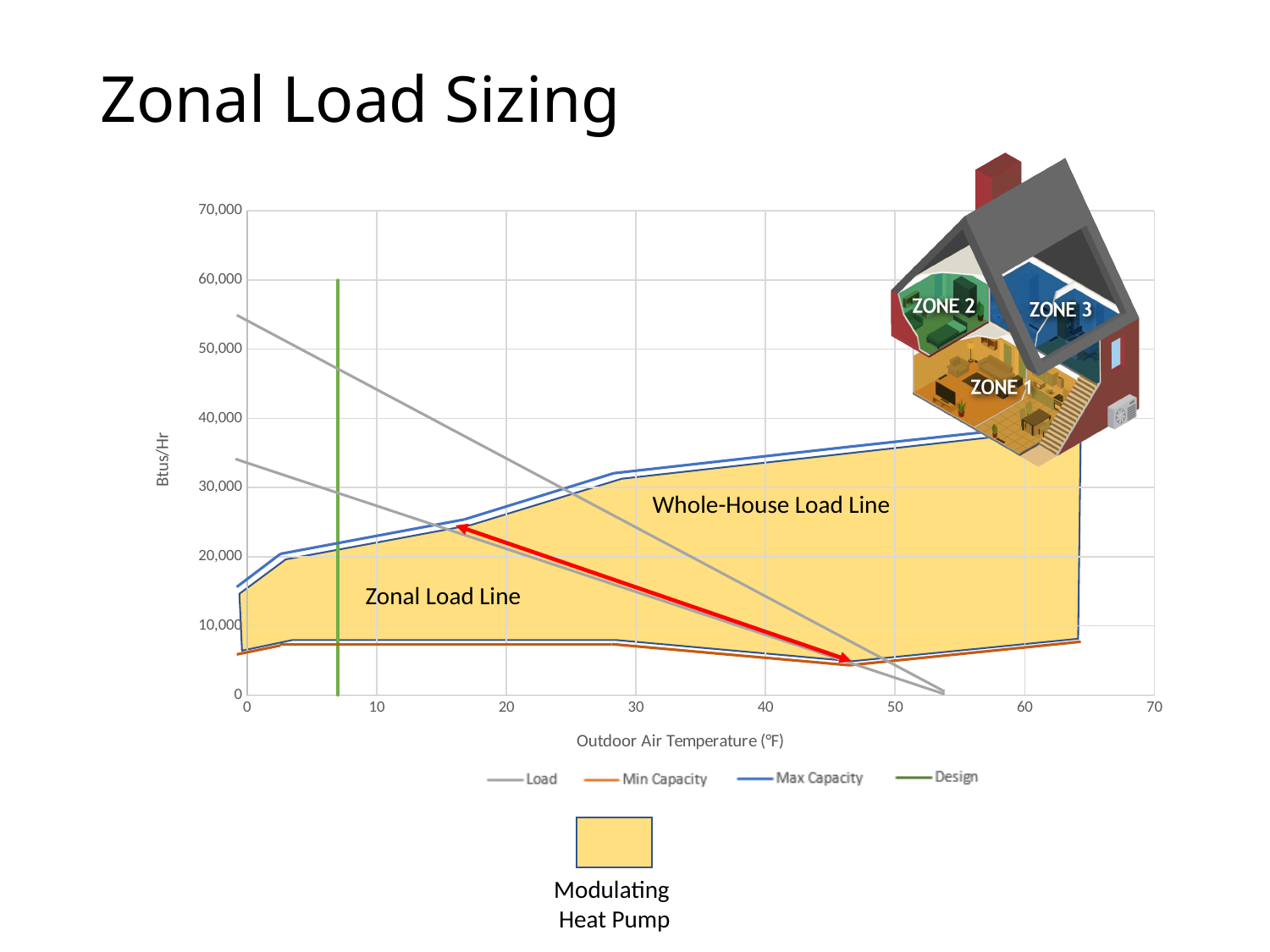
Is the Max Capacity value at 60°F greater or less than 30,000? greater At 60°F, which is larger: Max Capacity or Min Capacity? Max Capacity Is the Whole-House Load Line value at 10°F greater or less than 40,000? greater Does the Max Capacity line rise or fall as outdoor air temperature increases? rise What kind of chart is shown on the slide? line chart How many series does the chart legend list? 4 What is the title of the y axis of the chart? Btus/Hr What is the title of the x axis of the chart? Outdoor Air Temperature (°F) Is the Max Capacity value at 0°F greater or less than 10,000? greater Does the Whole-House Load Line rise or fall as outdoor air temperature increases? fall